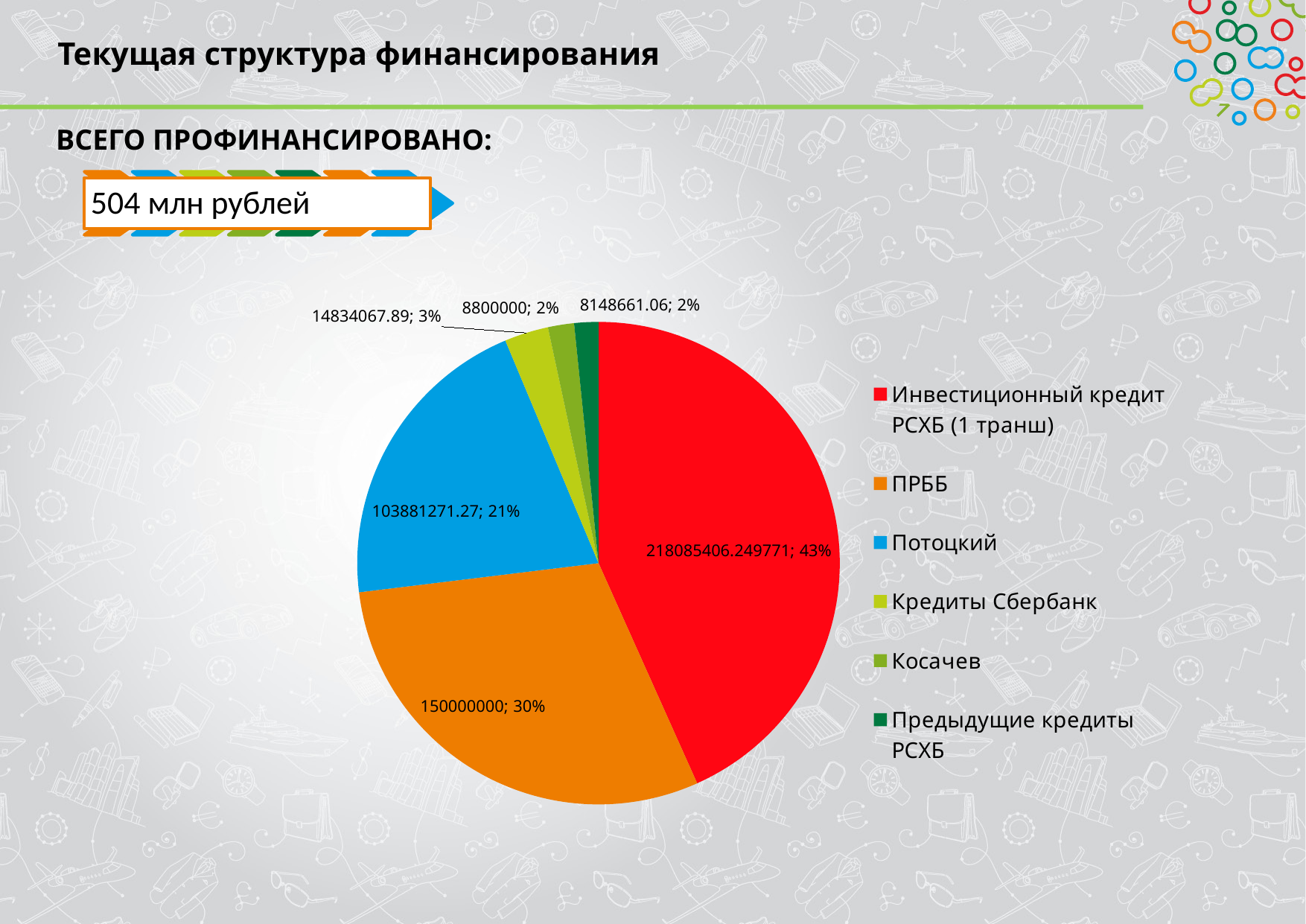
Which is larger, the slice for "ПРББ" or the slice for "Потоцкий"? ПРББ What kind of chart is shown on the slide? Pie chart Which slice is the largest in the pie chart? Инвестиционный кредит РСХБ (1 транш) What value is shown for the slice "Инвестиционный кредит РСХБ (1 транш)"? 218085406.249771 What value is shown for the slice "Потоцкий"? 103881271.27 How many entries does the legend of the pie chart list? 6 What value is shown for the slice "ПРББ"? 150000000 What colour is the slice for "Косачев" in the pie chart? Green What share of the pie does "Кредиты Сбербанк" represent? 3% Which slice is the smallest in the pie chart? Предыдущие кредиты РСХБ How many slices does the pie chart have? 6 What share of the pie does "Потоцкий" represent? 21%